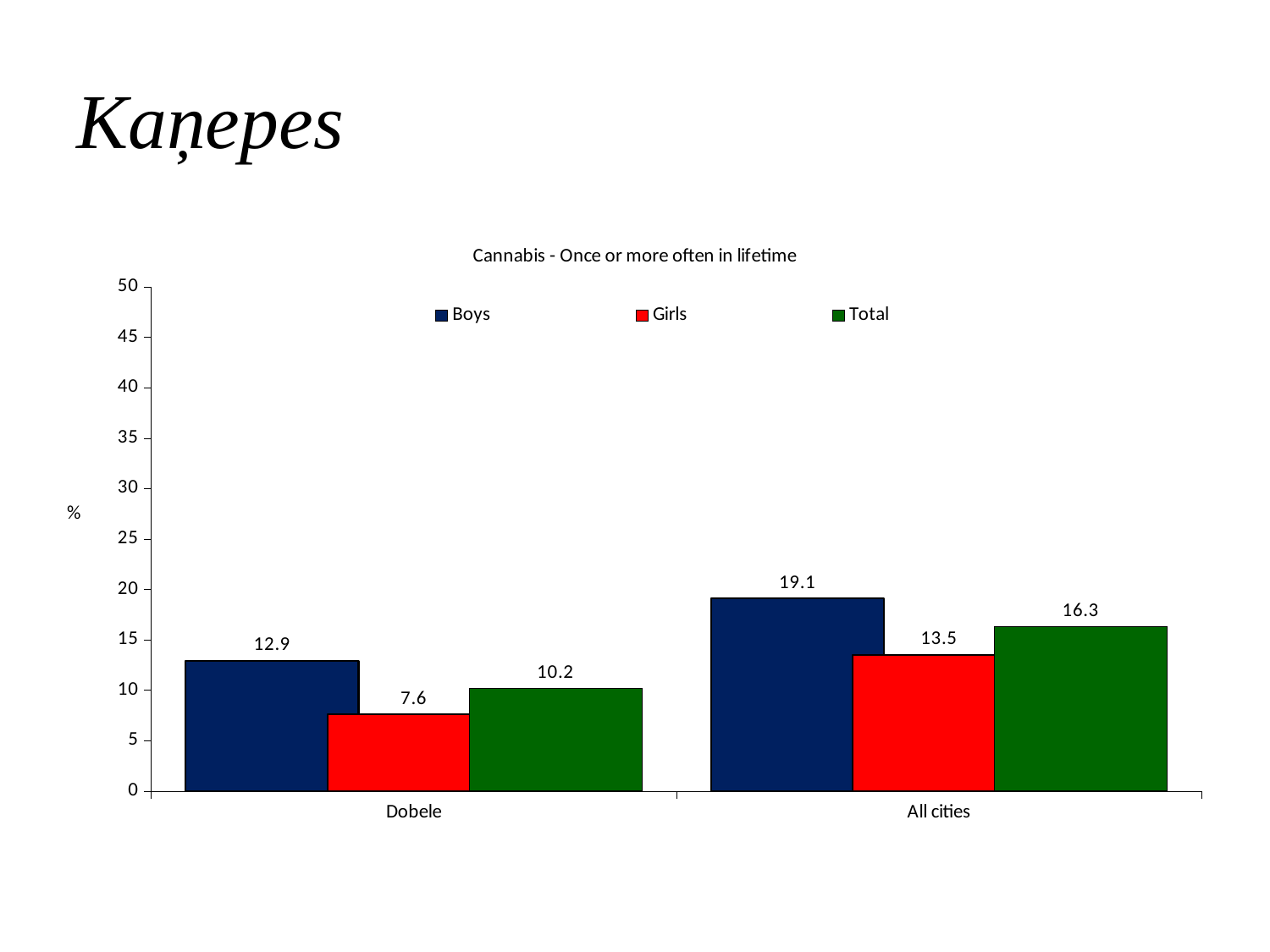
Which series has the lowest value in Dobele? Girls Which is larger, the Girls value for Dobele or the Girls value for All cities? All cities How many series does the legend list? 3 Which series has the highest value in All cities? Boys What is the value for Boys in Dobele? 12.9 What is the title of the chart? Cannabis - Once or more often in lifetime What is the difference between the Boys values for All cities and Dobele? 6.2 What kind of chart is shown? bar chart What is the value for Girls in All cities? 13.5 What is the Total value for Dobele? 10.2 Is the Total value for All cities greater or less than 15? greater How many categories are shown on the x axis? 2